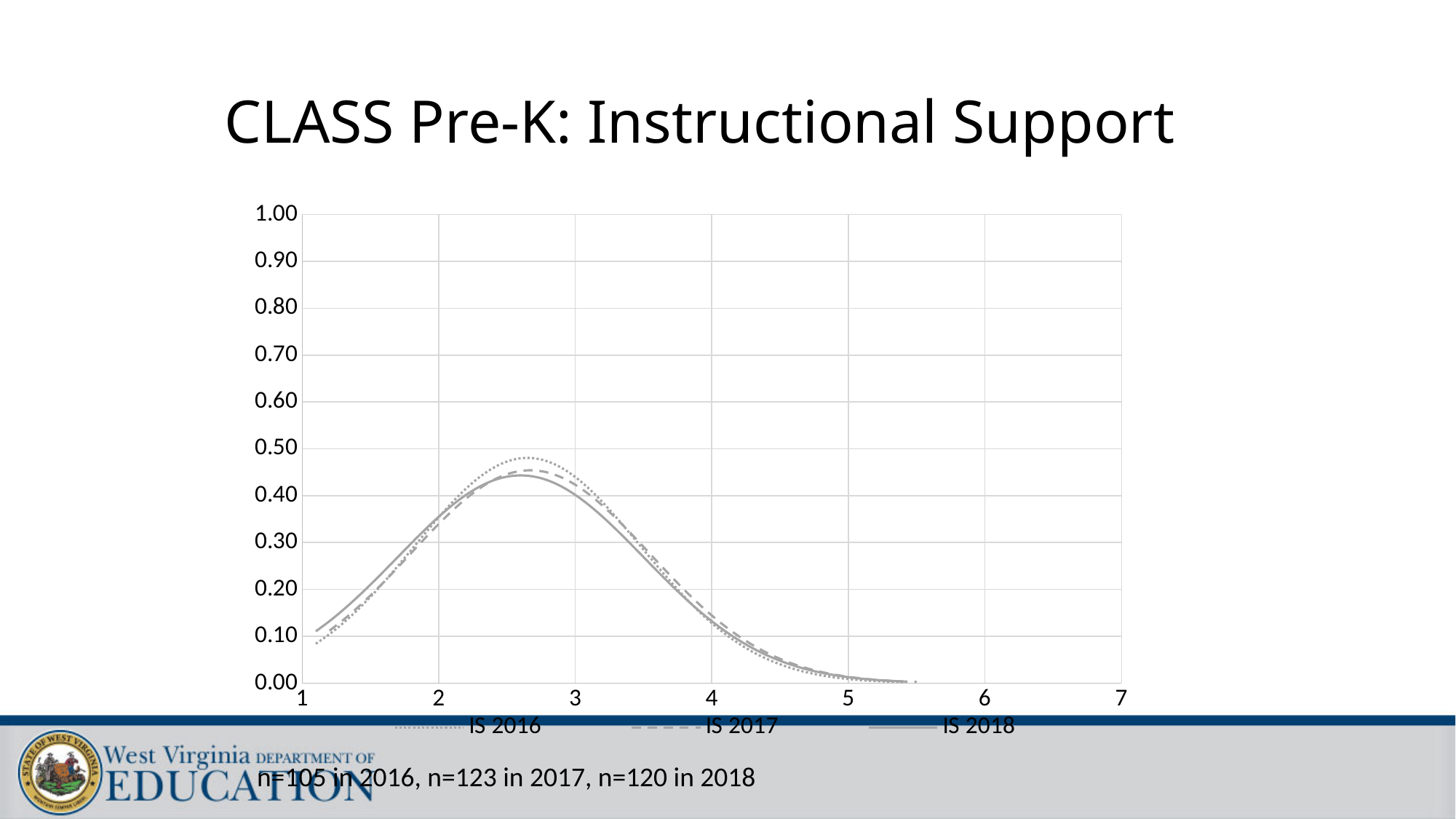
Do the curves rise or fall between x = 3 and x = 5? fall Is the peak value of the IS 2018 curve greater or less than 0.50? less Is the value of the IS 2018 curve at x = 4 greater or less than 0.20? less What kind of chart is shown on the slide? line chart What is the maximum value shown on the y axis? 1.00 What is the title of the chart? CLASS Pre-K: Instructional Support Do the curves rise or fall between x = 1 and x = 2? rise Which series reaches the highest peak value? IS 2016 Is the peak value of the IS 2016 curve greater or less than 0.40? greater How many series does the legend list? 3 What are the three series named in the legend? IS 2016, IS 2017, IS 2018